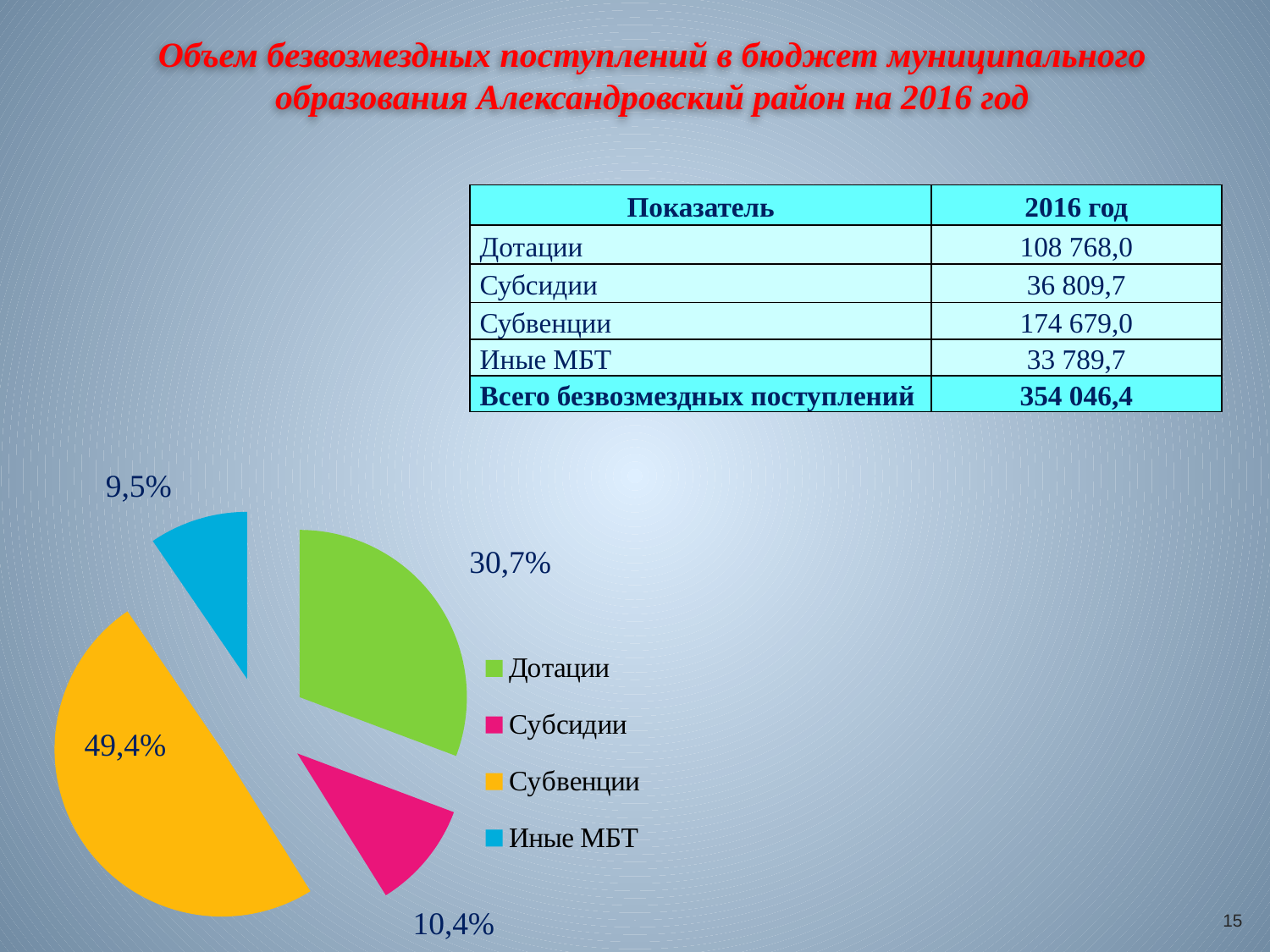
What share of the pie does Субсидии represent? 10,4% Which category has the smallest slice of the pie? Иные МБТ What share of the pie does Иные МБТ represent? 9,5% Which slice is larger, Субсидии or Иные МБТ? Субсидии How many entries does the legend list? 4 How many slices does the pie chart have? 4 Which category has the largest slice of the pie? Субвенции What colour is the Субвенции slice in the pie chart? Yellow What share of the pie does Субвенции represent? 49,4% What type of chart is shown on the slide? Pie chart What is the difference in percentage points between the Субвенции slice and the Дотации slice? 18,7